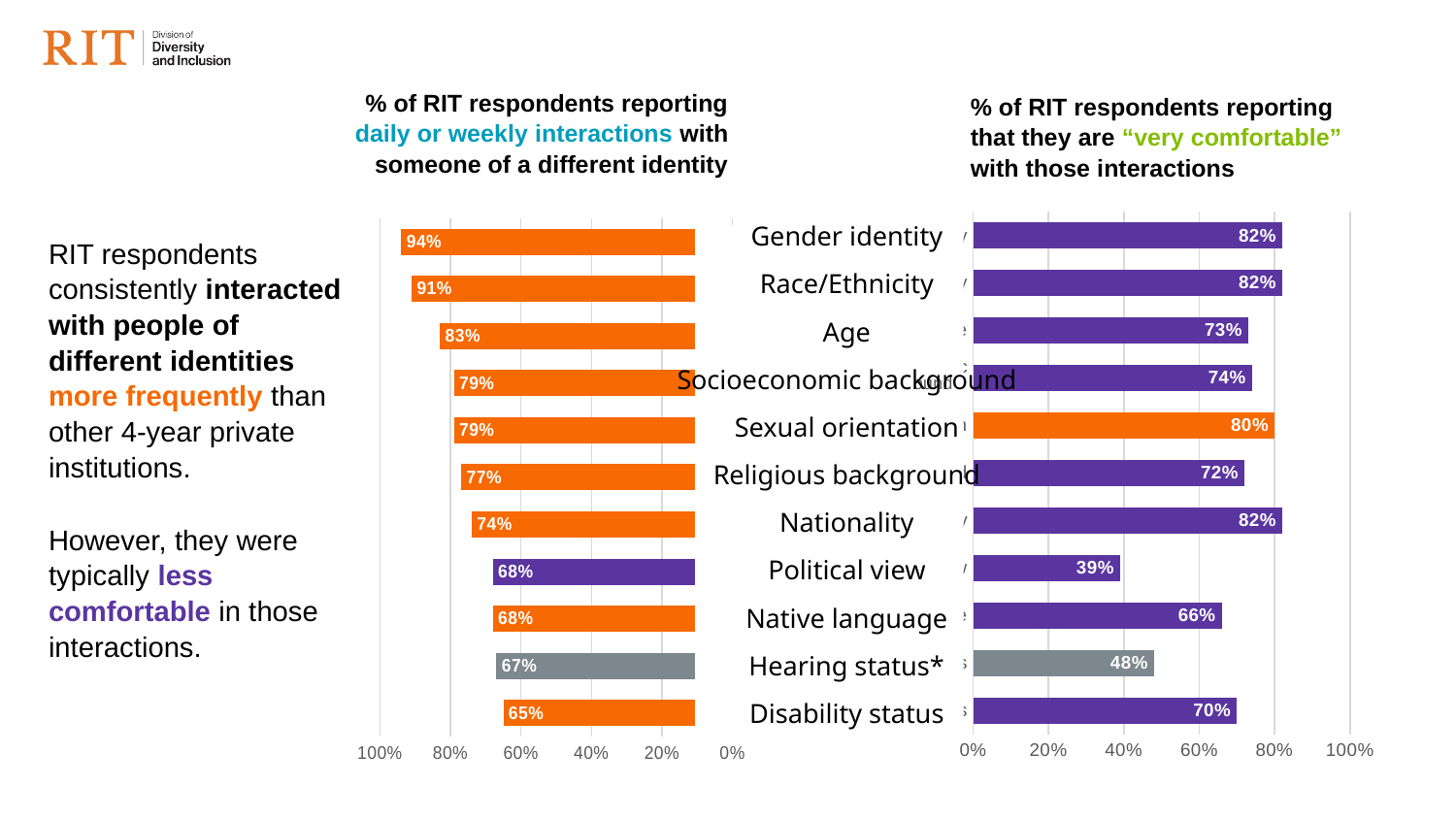
In the left chart (daily or weekly interactions), what is the value for Religious background? 77% In the right chart ("very comfortable" with those interactions), what is the difference between the values for Sexual orientation and Political view? 41% What kind of chart is the right chart ("very comfortable" with those interactions)? Bar chart Which is larger: the value for Age in the left chart (daily or weekly interactions) or the value for Age in the right chart ("very comfortable")? Left chart (83%) In the left chart (daily or weekly interactions), what is the difference between the values for Gender identity and Disability status? 29% In the right chart ("very comfortable" with those interactions), what is the value for Political view? 39% How many categories are shown in the left chart (daily or weekly interactions)? 11 In the right chart ("very comfortable" with those interactions), is the value for Native language greater or less than 60%? greater In the left chart (daily or weekly interactions), which category has the lowest value? Disability status In the right chart ("very comfortable" with those interactions), what is the value for Hearing status*? 48% In the left chart (daily or weekly interactions), what is the value for Gender identity? 94% In the right chart ("very comfortable" with those interactions), which category has the lowest value? Political view